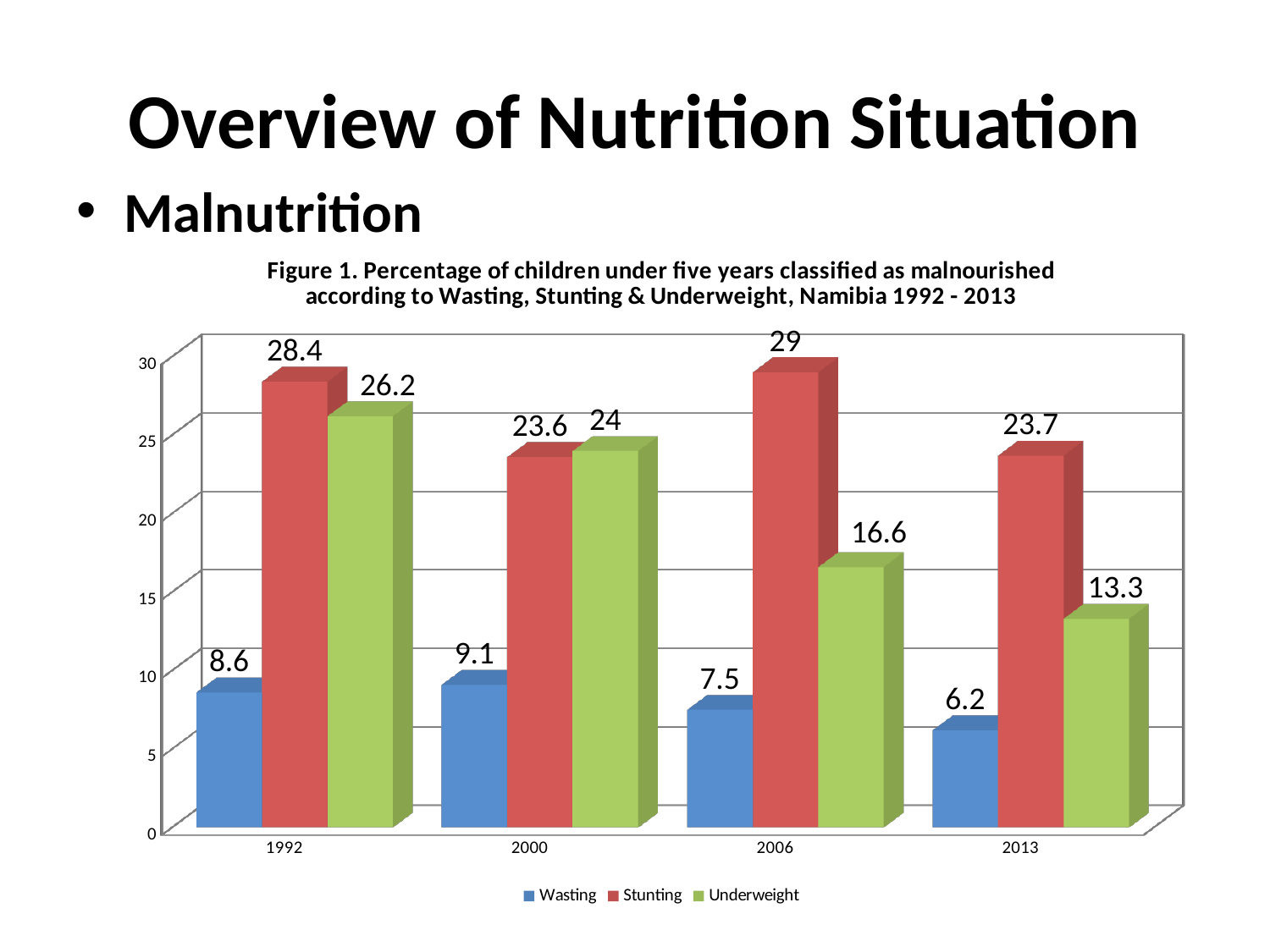
In which year is the Wasting value highest? 2000 What is the Stunting value for 2006? 29 How many years are shown on the x axis? 4 Is the Stunting value for 2013 greater or less than 20? greater What is the Underweight value for 2013? 13.3 Does the Underweight value rise or fall from 1992 to 2013? fall Which is larger in 2000, Stunting or Underweight? Underweight What is the difference between the Stunting and Underweight values in 2006? 12.4 In which year is the Underweight value lowest? 2013 What is the Wasting value for 1992? 8.6 How many series does the legend list? 3 What kind of chart is shown? bar chart